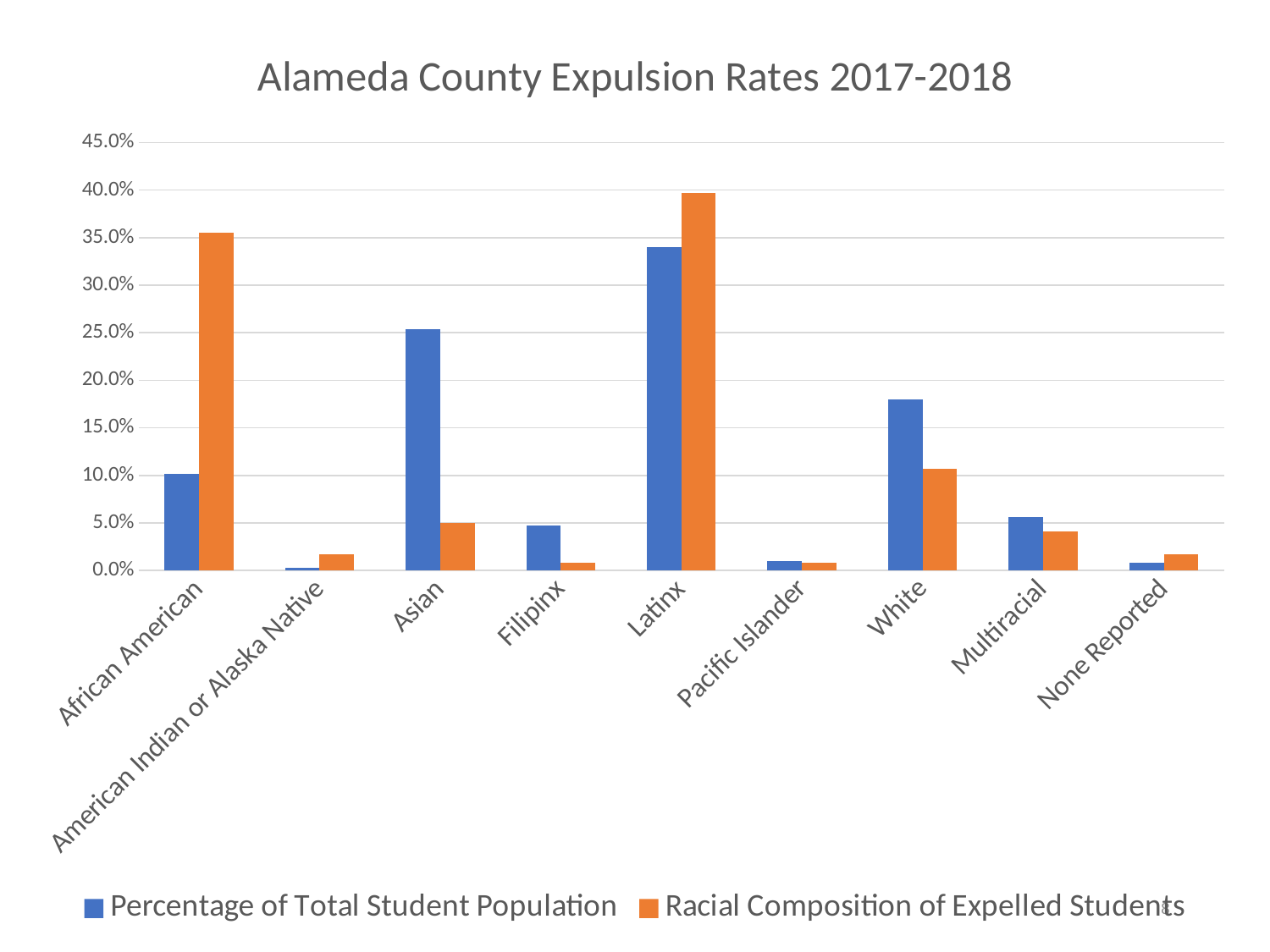
What type of chart is shown on the slide? bar chart How many racial categories are shown on the x axis? 9 Is the Percentage of Total Student Population value for Asian greater or less than 20.0%? greater How many series does the legend list? 2 For Asian, which is larger: Percentage of Total Student Population or Racial Composition of Expelled Students? Percentage of Total Student Population What is the title of the chart? Alameda County Expulsion Rates 2017-2018 Which category has the highest value for Racial Composition of Expelled Students? Latinx Is the Racial Composition of Expelled Students value for White greater or less than 15.0%? less Is the Racial Composition of Expelled Students value for African American greater or less than 30.0%? greater Which category has the highest value for Percentage of Total Student Population? Latinx For African American, which is larger: Percentage of Total Student Population or Racial Composition of Expelled Students? Racial Composition of Expelled Students Which category has the lowest value for Percentage of Total Student Population? American Indian or Alaska Native